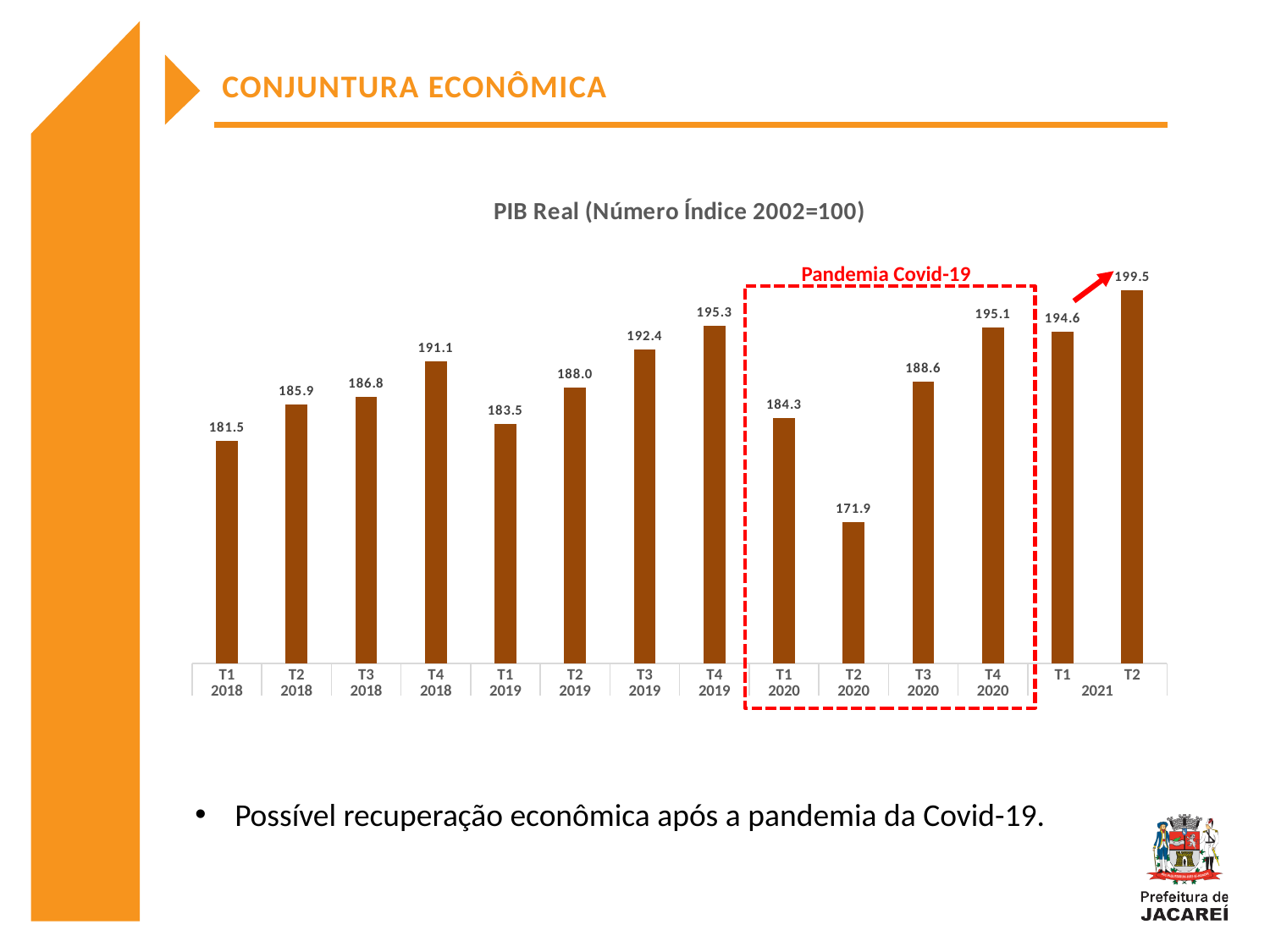
What is the value for T1 2018? 181.5 What is the value for T2 2020? 171.9 Which quarter has the lowest value? T2 2020 Which is larger, the value for T3 2020 or the value for T2 2019? T3 2020 What kind of chart is this? bar chart What is the difference between the values for T2 2021 and T2 2020? 27.6 How many quarters are shown on the x axis? 14 What is the title of the chart? PIB Real (Número Índice 2002=100) What label is written above the red dashed box? Pandemia Covid-19 What is the value for T4 2019? 195.3 What is the difference between the values for T4 2018 and T1 2019? 7.6 Which quarter has the highest value? T2 2021